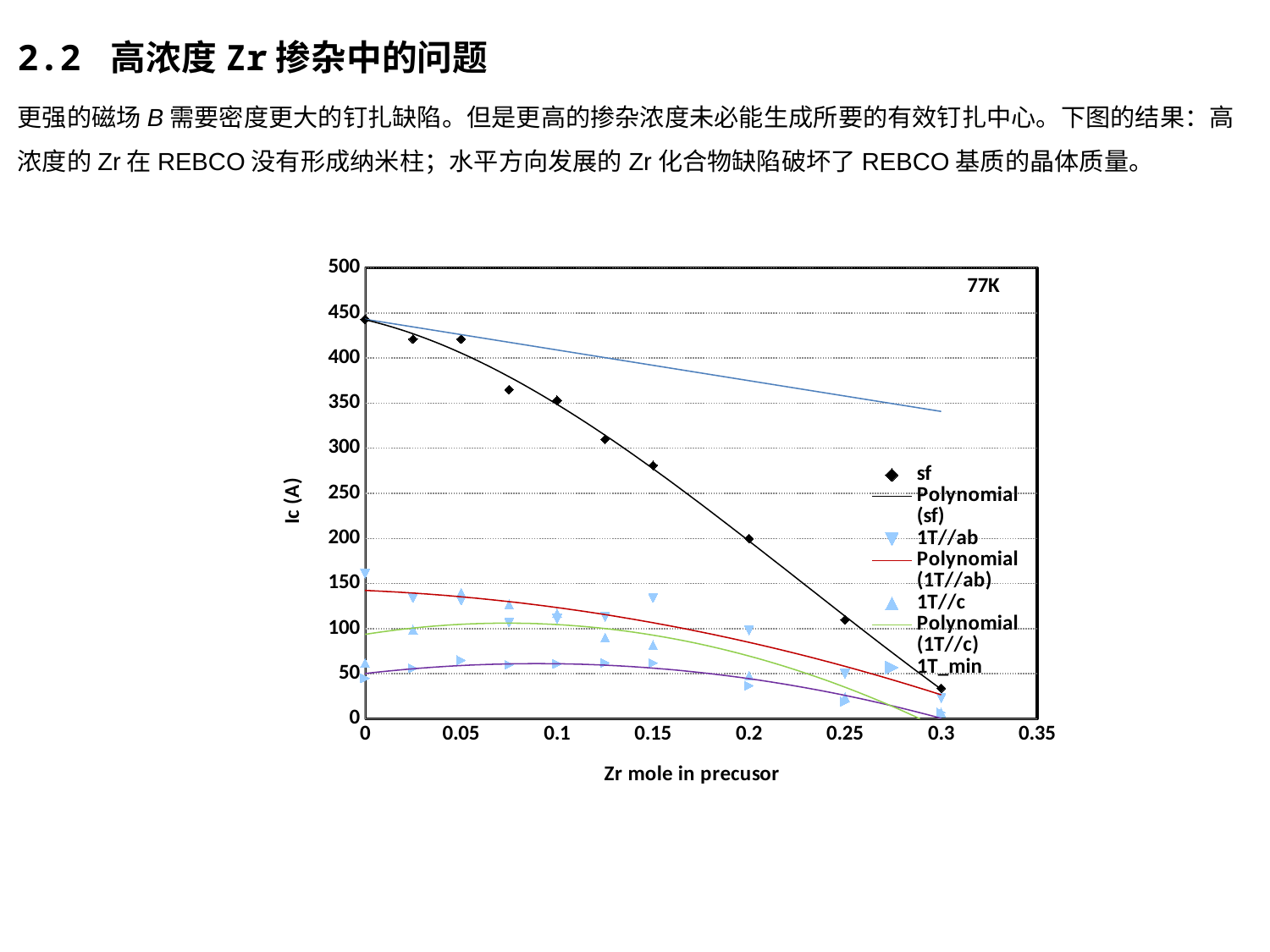
What is the label of the x axis? Zr mole in precusor Is the 1T//ab value at Zr mole 0 greater or less than 100? greater Is the 1T//c value at Zr mole 0.3 greater or less than 50? less Is the sf value at Zr mole 0.3 greater or less than 50? less At which Zr mole value is the sf series highest? 0 What temperature is annotated in the top right corner of the chart? 77K At Zr mole 0.1, which is larger, the sf value or the 1T//ab value? sf What kind of chart is shown on the slide? scatter chart At which Zr mole value is the sf series lowest? 0.3 Do the sf values rise or fall as Zr mole in precusor increases? fall